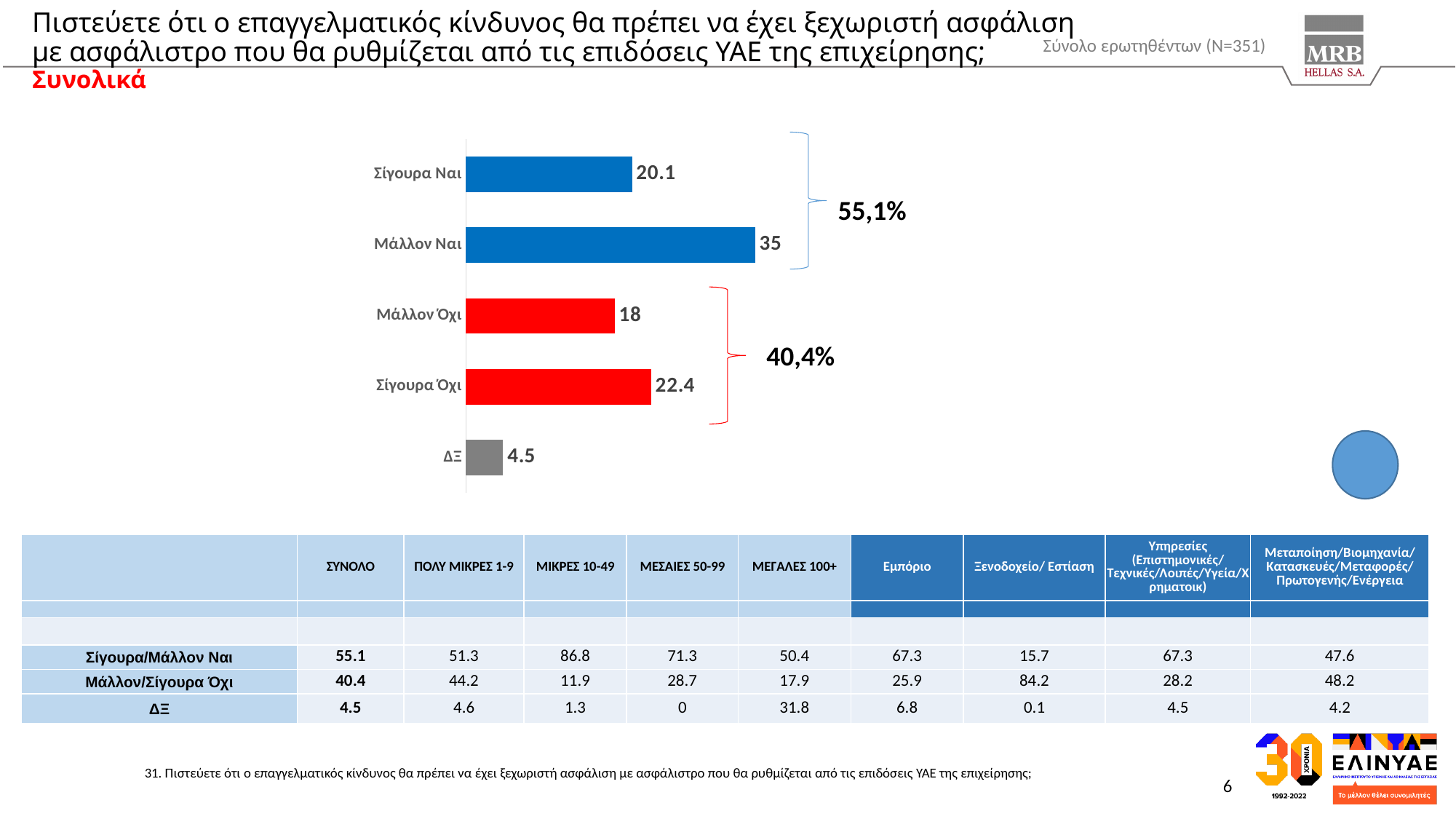
Which is larger, the value for Σίγουρα Όχι or the value for Μάλλον Όχι? Σίγουρα Όχι What is the difference between the values for Μάλλον Ναι and Μάλλον Όχι? 17 Which category has the lowest value in the bar chart? ΔΞ What is the value for Σίγουρα Ναι in the bar chart? 20.1 What is the difference between the values for Σίγουρα Όχι and Σίγουρα Ναι? 2.3 What combined percentage is shown by the bracket grouping Σίγουρα Ναι and Μάλλον Ναι? 55,1% What is the value for ΔΞ in the bar chart? 4.5 What is the value for Σίγουρα Όχι in the bar chart? 22.4 What is the value for Μάλλον Ναι in the bar chart? 35 How many categories are shown in the bar chart? 5 What kind of chart is shown on the slide? Bar chart Which category has the highest value in the bar chart? Μάλλον Ναι